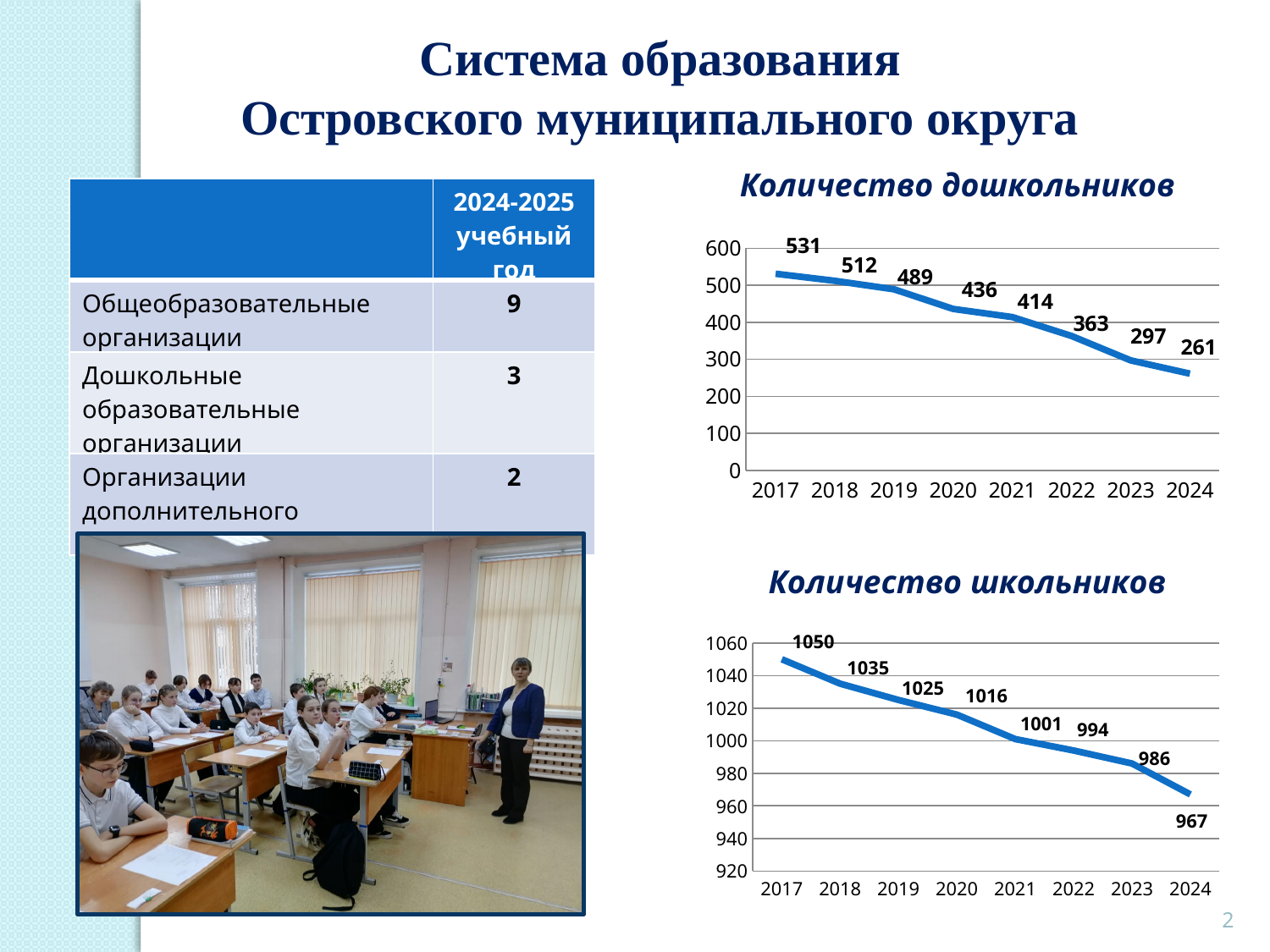
In the 'Количество дошкольников' chart, what is the difference between the values for 2017 and 2024? 270 What kind of chart is the 'Количество дошкольников' chart? line chart In the 'Количество школьников' chart, do the values rise or fall from 2017 to 2024? fall In the 'Количество дошкольников' chart, which year has the highest value? 2017 In the 'Количество дошкольников' chart, what is the value for 2019? 489 In the 'Количество школьников' chart, which year has the lowest value? 2024 In the 'Количество дошкольников' chart, is the value for 2023 greater or less than 300? less In the 'Количество школьников' chart, what is the value for 2022? 994 In the 'Количество дошкольников' chart, which is larger, the value for 2021 or the value for 2022? 2021 What is the title of the upper chart on the slide? Количество дошкольников How many years are plotted in the 'Количество школьников' chart? 8 In the 'Количество школьников' chart, what is the difference between the values for 2020 and 2021? 15